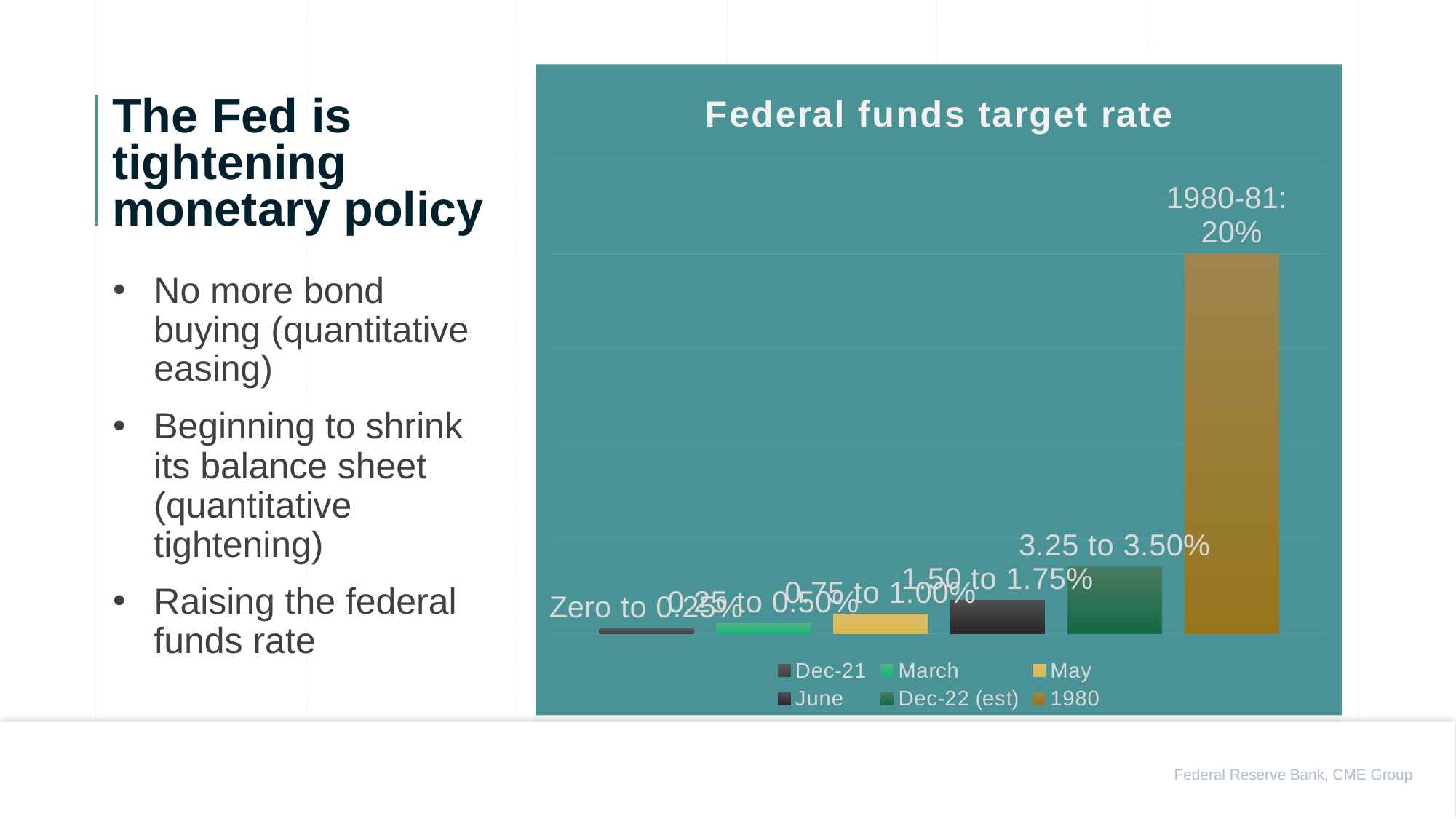
What kind of chart is shown on the slide? bar chart What is the title of the chart? Federal funds target rate What is the data label on the Dec-22 (est) bar? 3.25 to 3.50% What is the data label on the May bar? 0.75 to 1.00% What is the data label on the 1980 bar? 1980-81: 20% Which bar is taller, June or Dec-22 (est)? Dec-22 (est) How many bars are plotted in the chart? 6 Which series has the tallest bar? 1980 How many series does the chart's legend list? 6 Which series has the shortest bar? Dec-21 What is the data label on the June bar? 1.50 to 1.75% What is the data label on the Dec-21 bar? Zero to 0.25%